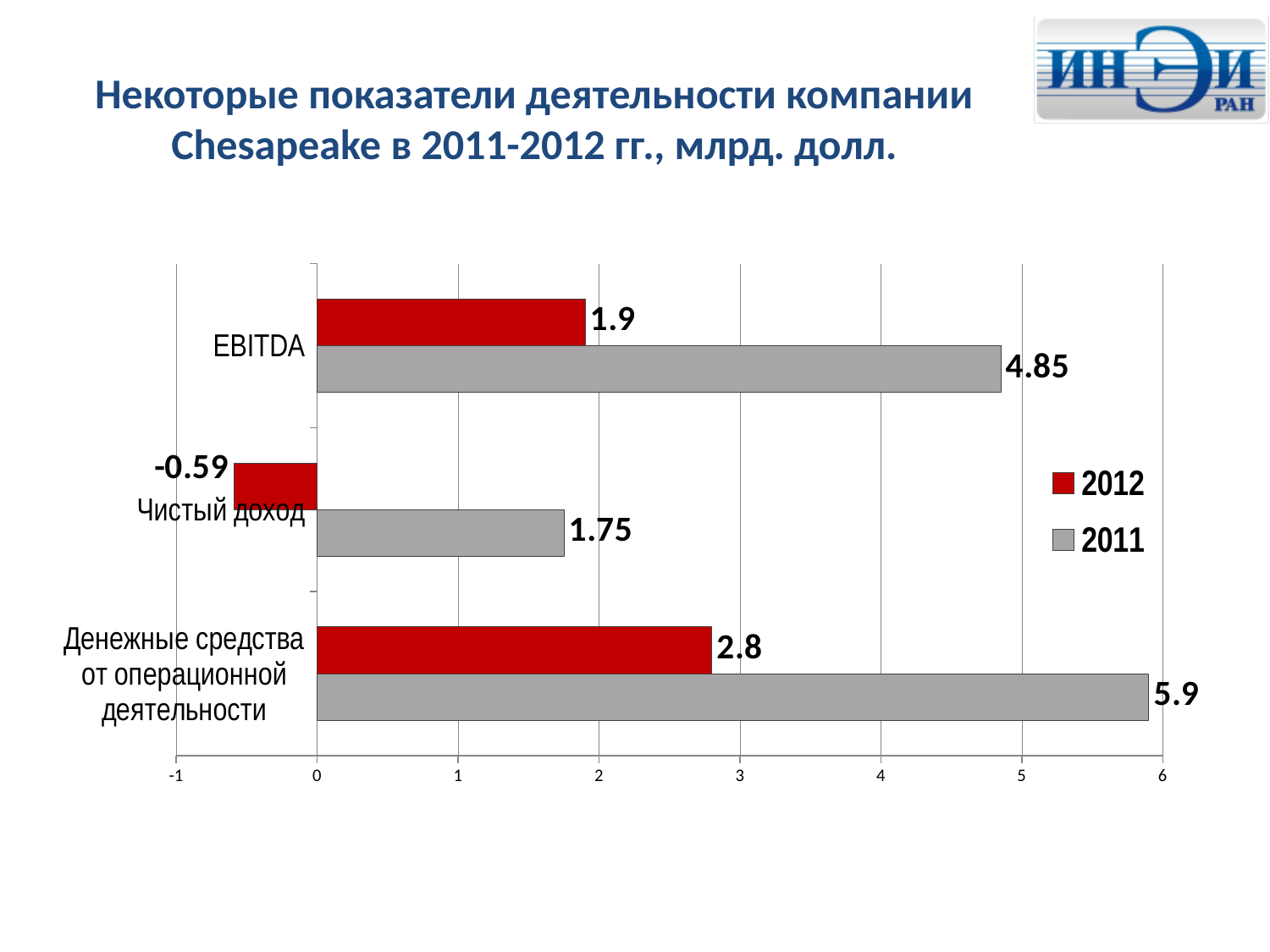
How many series does the legend list? 2 What is the 2011 value for Денежные средства от операционной деятельности? 5.9 What is the difference between the 2011 and 2012 values for EBITDA? 2.95 What is the 2011 value for EBITDA? 4.85 How many categories are shown on the chart? 3 What is the 2012 value for EBITDA? 1.9 What is the difference between the 2011 and 2012 values for Денежные средства от операционной деятельности? 3.1 Which category has the highest 2011 value? Денежные средства от операционной деятельности Which is larger: the 2011 value for Чистый доход or the 2012 value for EBITDA? 2012 value for EBITDA What is the 2012 value for Чистый доход? -0.59 Which category has the lowest 2012 value? Чистый доход What kind of chart is shown on the slide? Bar chart